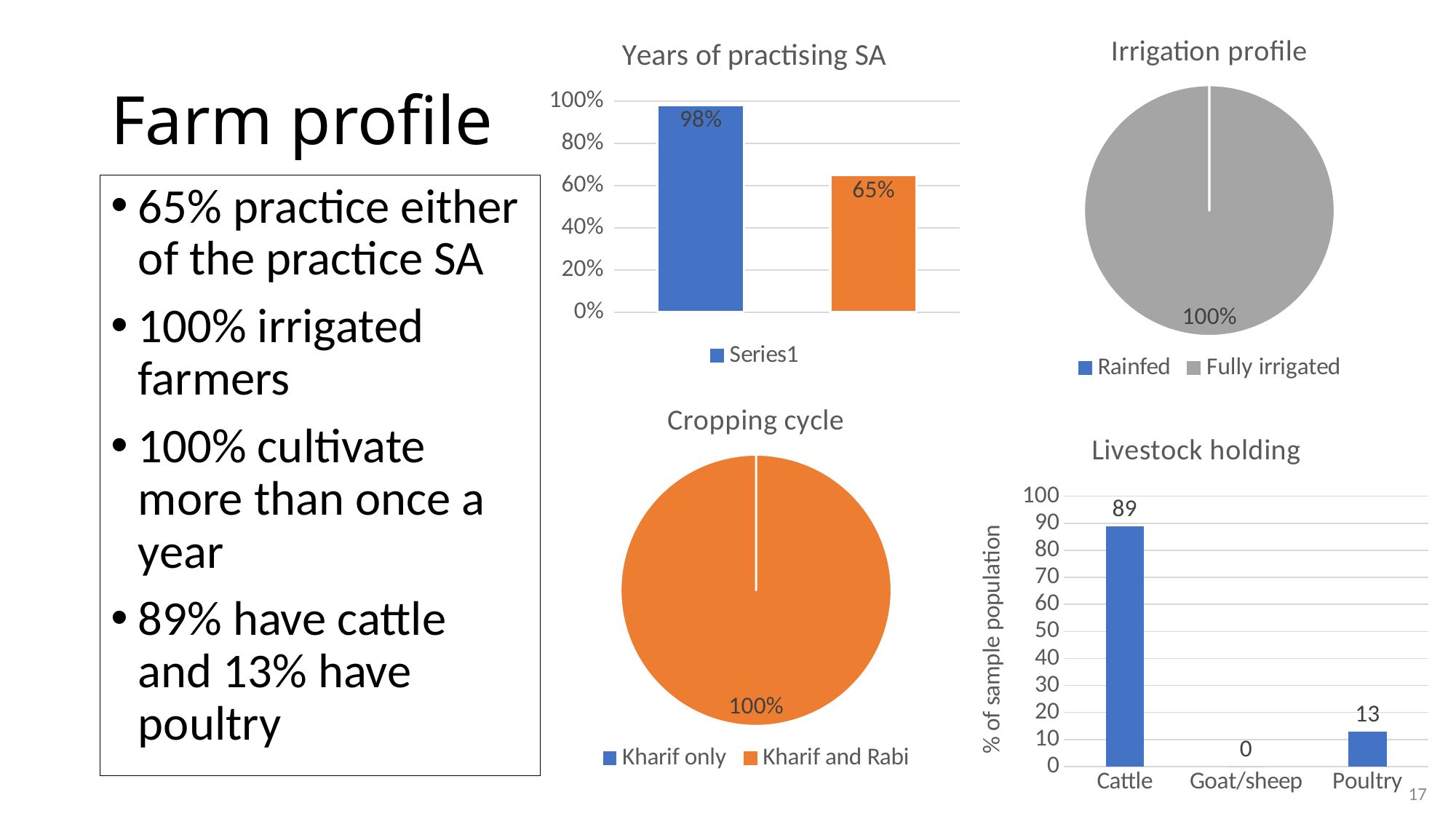
In the Livestock holding chart, which category has the highest value? Cattle In the Livestock holding chart, what is the value for Poultry? 13 In the Years of practising SA chart, what is the difference between the two bar values? 33% How many entries does the legend of the Cropping cycle chart list? 2 What kind of chart is the Years of practising SA chart? Bar chart In the Years of practising SA chart, what is the highest value shown? 98% In the Livestock holding chart, what is the value for Cattle? 89 In the Irrigation profile pie chart, what share is labelled for Fully irrigated? 100% In the Livestock holding chart, which category has the lowest value? Goat/sheep In the Livestock holding chart, how many categories are shown on the x axis? 3 In the Livestock holding chart, what is the value for Goat/sheep? 0 In the Livestock holding chart, what is the difference between the values for Cattle and Poultry? 76